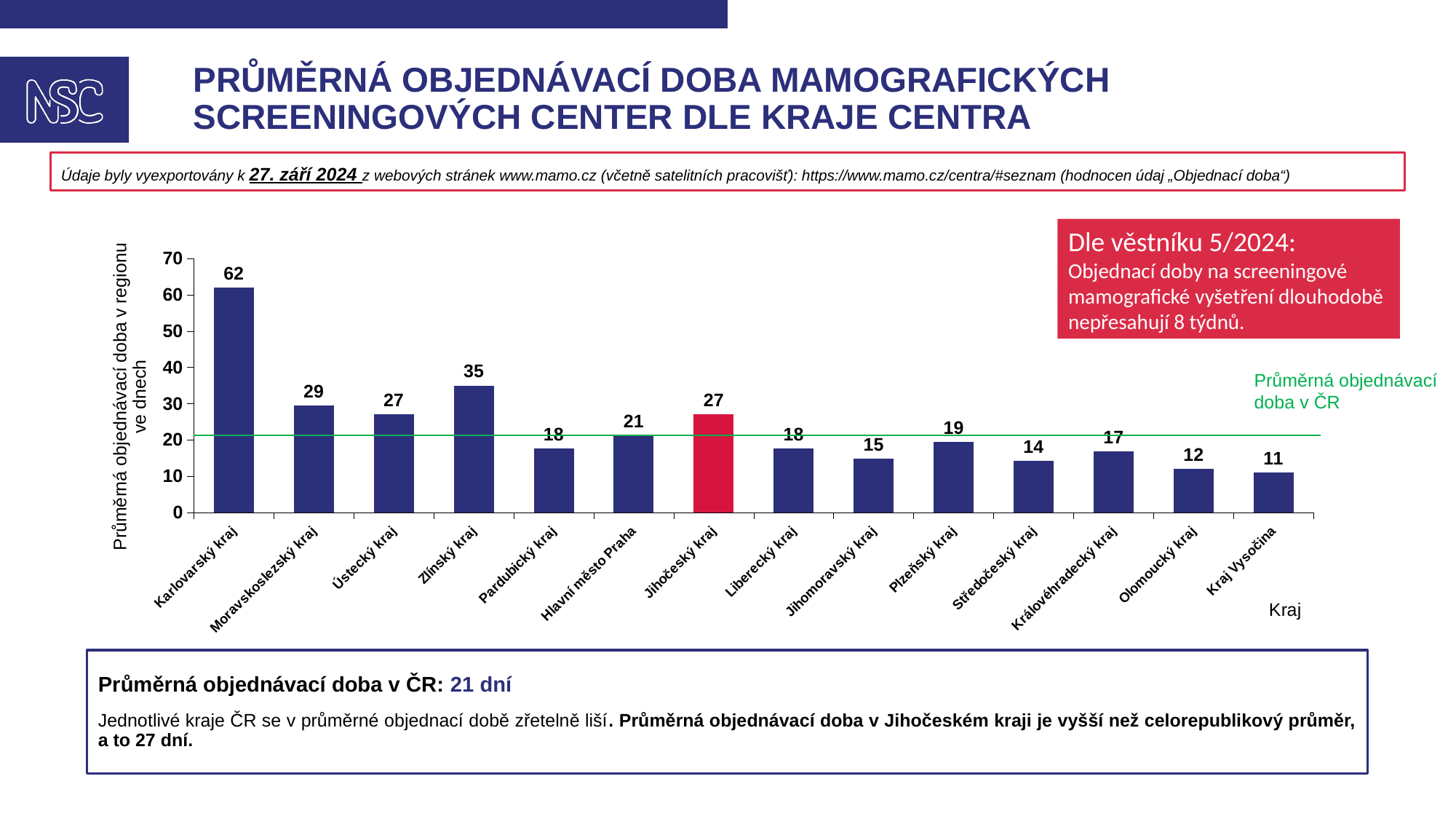
Which region has the highest average ordering time? Karlovarský kraj Which region has the lowest average ordering time? Kraj Vysočina What is the difference between the values for Karlovarský kraj and Zlínský kraj? 27 What is the value shown for Jihočeský kraj? 27 What value does the green horizontal line (Průměrná objednávací doba v ČR) represent? 21 dní Which region's bar is highlighted in red? Jihočeský kraj How many regions (kraje) are shown on the x axis? 14 What kind of chart is shown on the slide? bar chart What is the average ordering time for Karlovarský kraj? 62 What is the value shown for Zlínský kraj? 35 Which is larger, the value for Moravskoslezský kraj or the value for Ústecký kraj? Moravskoslezský kraj Is the value for Olomoucký kraj greater or less than 20? less